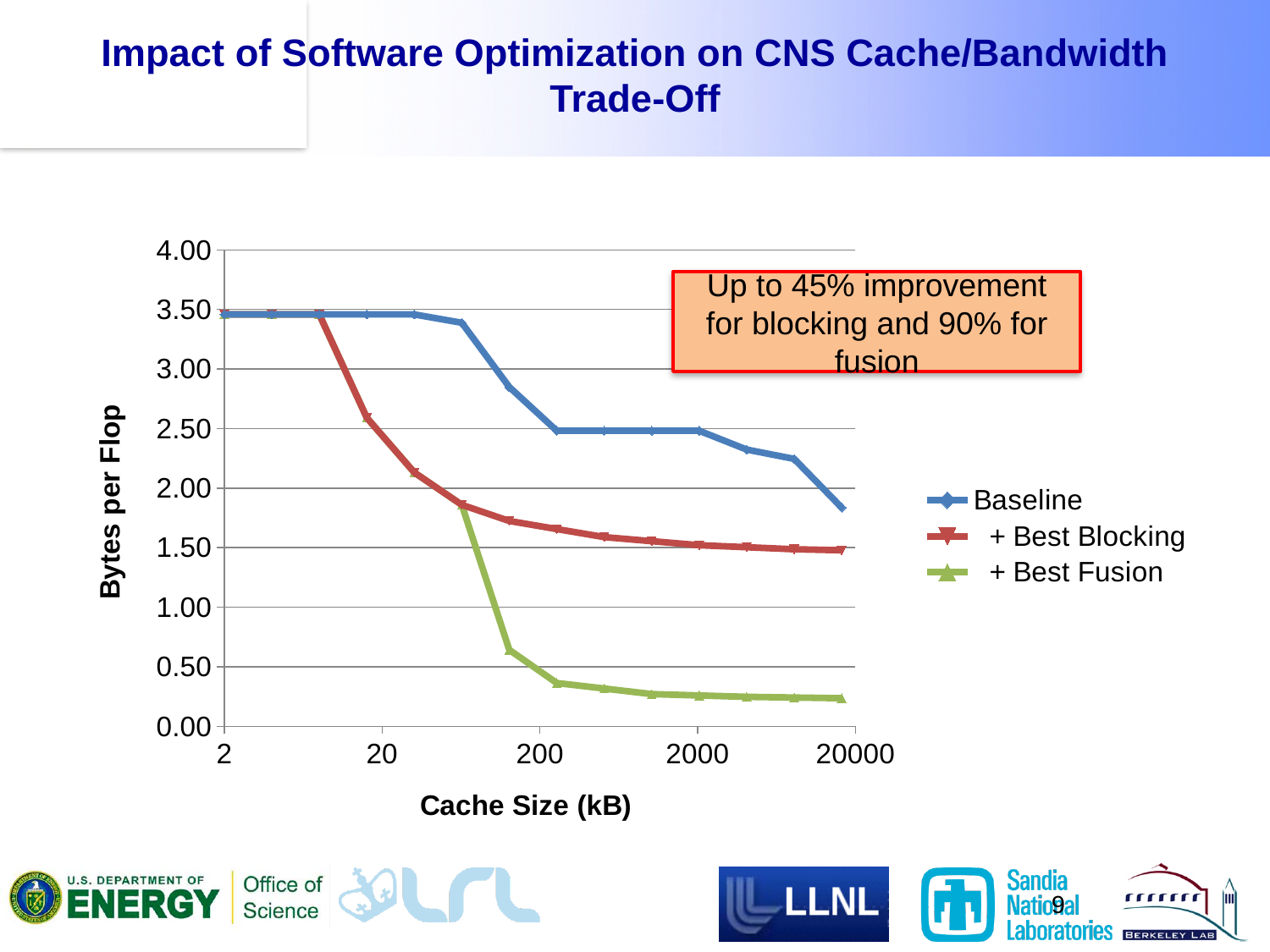
Is the + Best Fusion value at a cache size of 20000 kB greater or less than 0.50? less Is the + Best Blocking value at a cache size of 2000 kB greater or less than 2.00? less What is the title of the y axis? Bytes per Flop At a cache size of 200 kB, which series has the higher value, Baseline or + Best Fusion? Baseline According to the callout box on the chart, what improvement is stated for fusion? 90% At a cache size of 20000 kB, which series has the higher value, Baseline or + Best Blocking? Baseline Is the Baseline value at a cache size of 2 kB greater or less than 3.00? greater How many series does the legend list? 3 Which series has the lowest Bytes per Flop at a cache size of 2000 kB? + Best Fusion Do the Baseline values rise or fall as cache size increases along the x axis? fall What kind of chart is shown on the slide? line chart